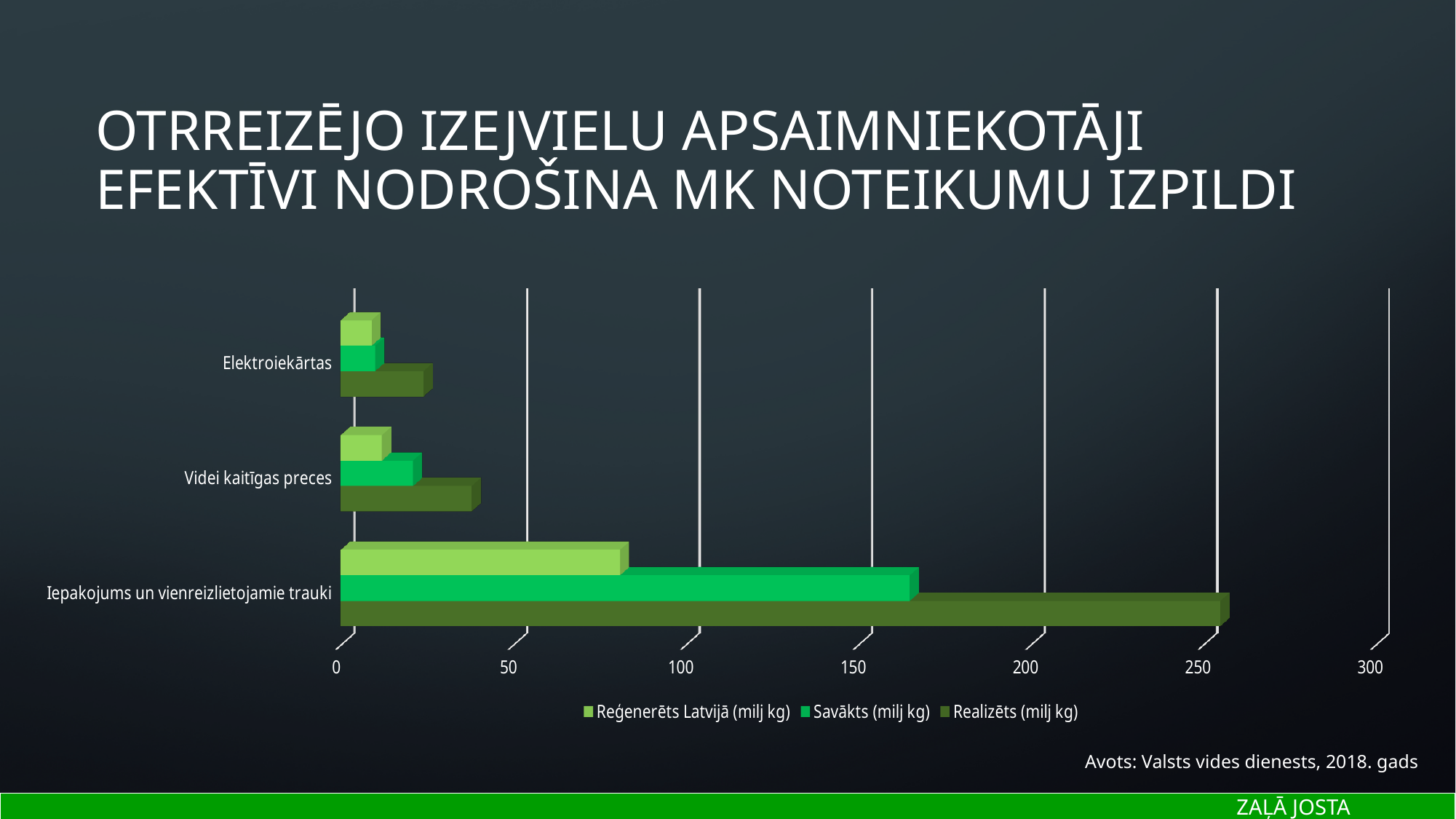
Is the value for Savākts (milj kg) for Iepakojums un vienreizlietojamie trauki greater or less than 150? greater What kind of chart is shown on the slide? bar chart Is the value for Realizēts (milj kg) for Videi kaitīgas preces greater or less than 50? less Which category has the lowest value for Savākts (milj kg)? Elektroiekārtas How many series does the legend list? 3 Which category has the highest value for Realizēts (milj kg)? Iepakojums un vienreizlietojamie trauki How many categories are shown on the chart? 3 For Iepakojums un vienreizlietojamie trauki, which is larger: Savākts (milj kg) or Reģenerēts Latvijā (milj kg)? Savākts (milj kg) Which series is shown in the darkest green colour? Realizēts (milj kg) What source is cited below the chart? Valsts vides dienests, 2018. gads Is the value for Realizēts (milj kg) for Iepakojums un vienreizlietojamie trauki greater or less than 250? greater